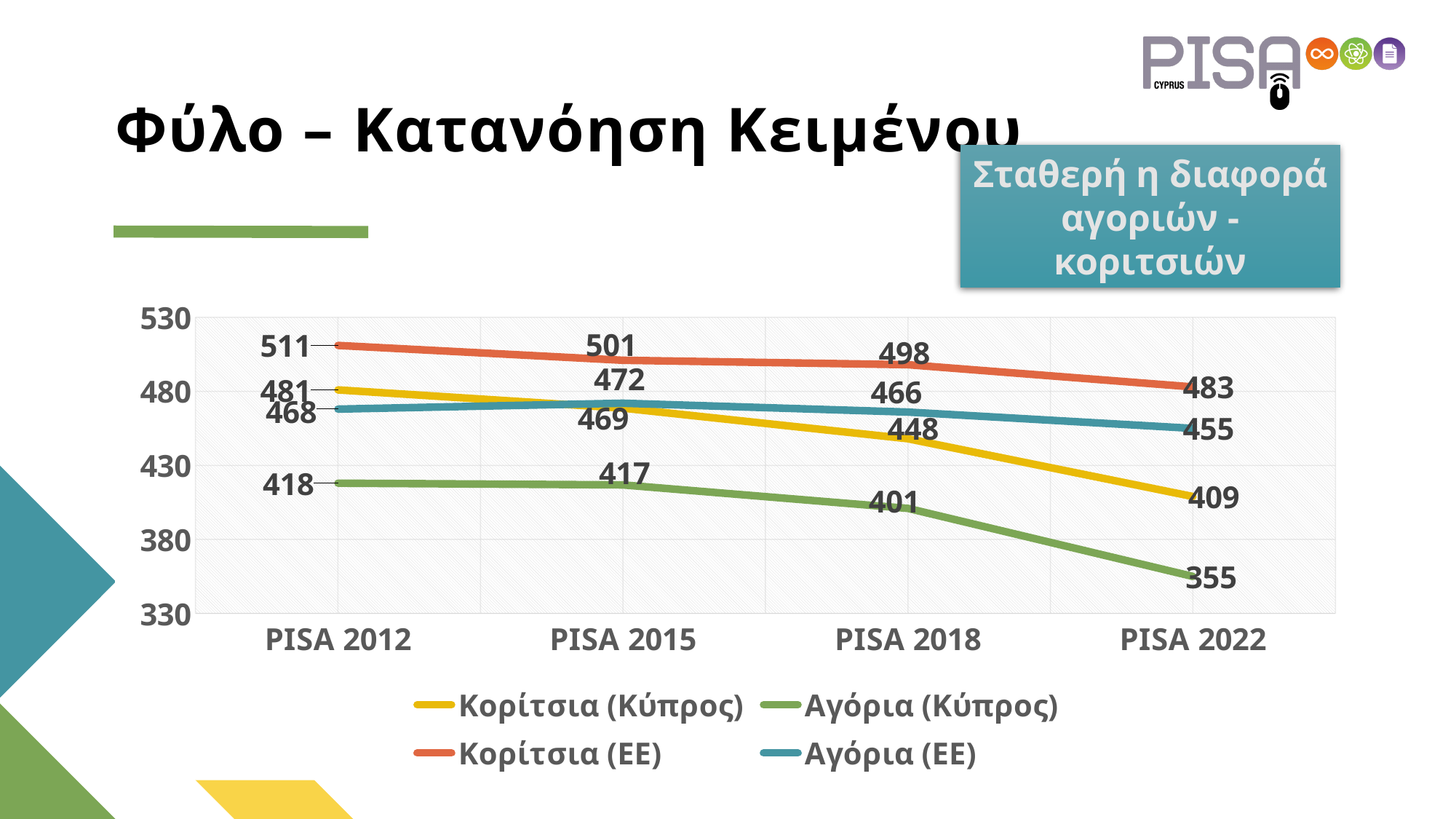
What is the value for Κορίτσια (Κύπρος) in PISA 2022? 409 Which is larger in PISA 2012: Κορίτσια (Κύπρος) or Αγόρια (ΕΕ)? Κορίτσια (Κύπρος) How many series does the legend list? 4 What kind of chart is shown on the slide? line chart Which series has the highest value in PISA 2018? Κορίτσια (ΕΕ) What is the value for Κορίτσια (ΕΕ) in PISA 2012? 511 Does the value for Αγόρια (Κύπρος) rise or fall from PISA 2012 to PISA 2022? fall What is the value for Αγόρια (Κύπρος) in PISA 2018? 401 How many PISA cycles are shown on the x axis? 4 What is the difference between Κορίτσια (Κύπρος) and Αγόρια (Κύπρος) in PISA 2022? 54 What is the value for Αγόρια (ΕΕ) in PISA 2015? 472 Which series has the lowest value in PISA 2022? Αγόρια (Κύπρος)